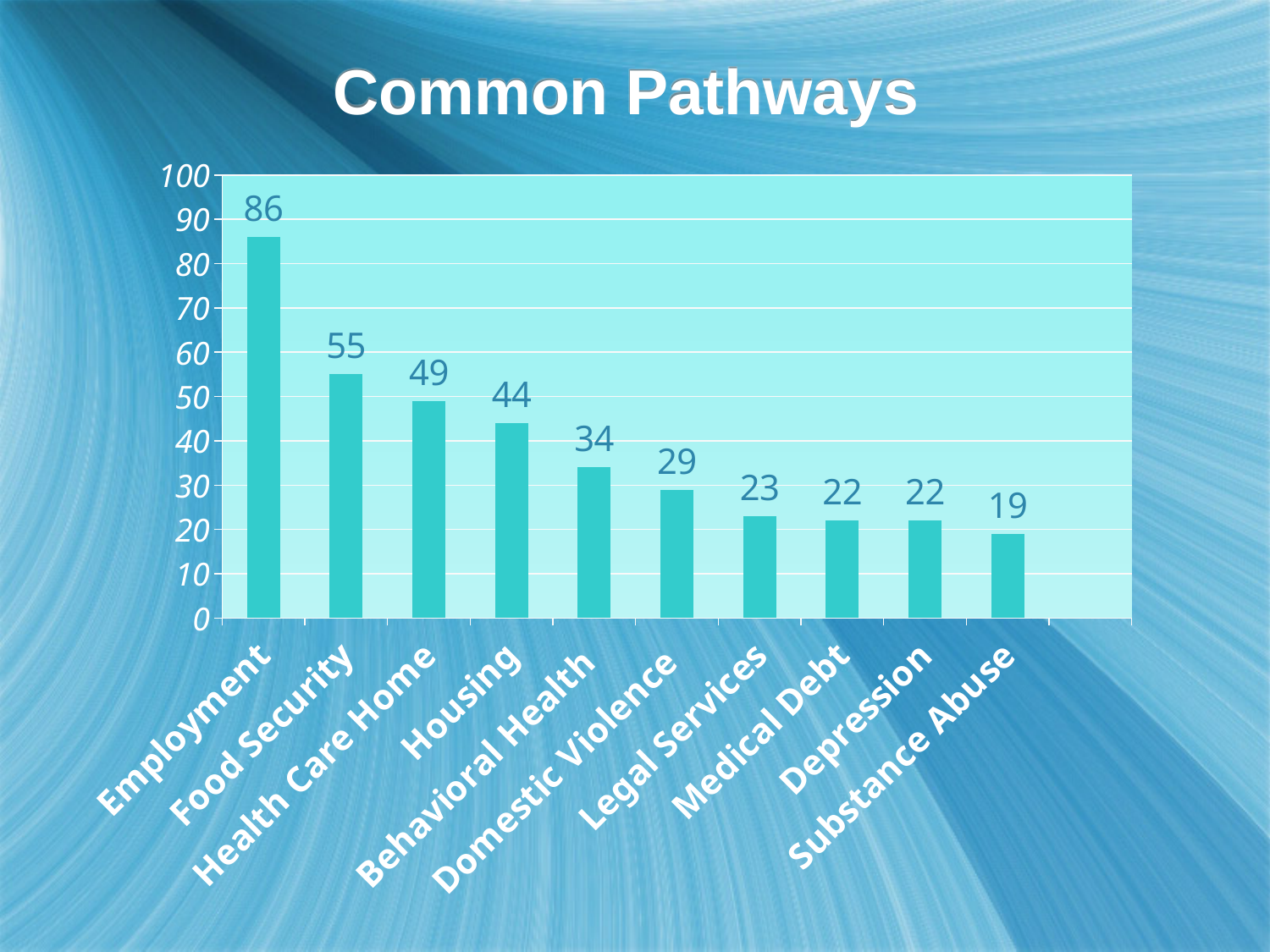
What is the value for Employment? 86 What is the difference between the values for Employment and Food Security? 31 Which is larger, the value for Domestic Violence or the value for Depression? Domestic Violence Which category has the lowest value? Substance Abuse What is the title of the slide? Common Pathways What is the value for Housing? 44 What is the value for Legal Services? 23 Is the value for Food Security greater or less than 50? greater How many categories are shown on the x axis? 10 Which category has the highest value? Employment What is the difference between the values for Health Care Home and Behavioral Health? 15 What kind of chart is shown on the slide? bar chart